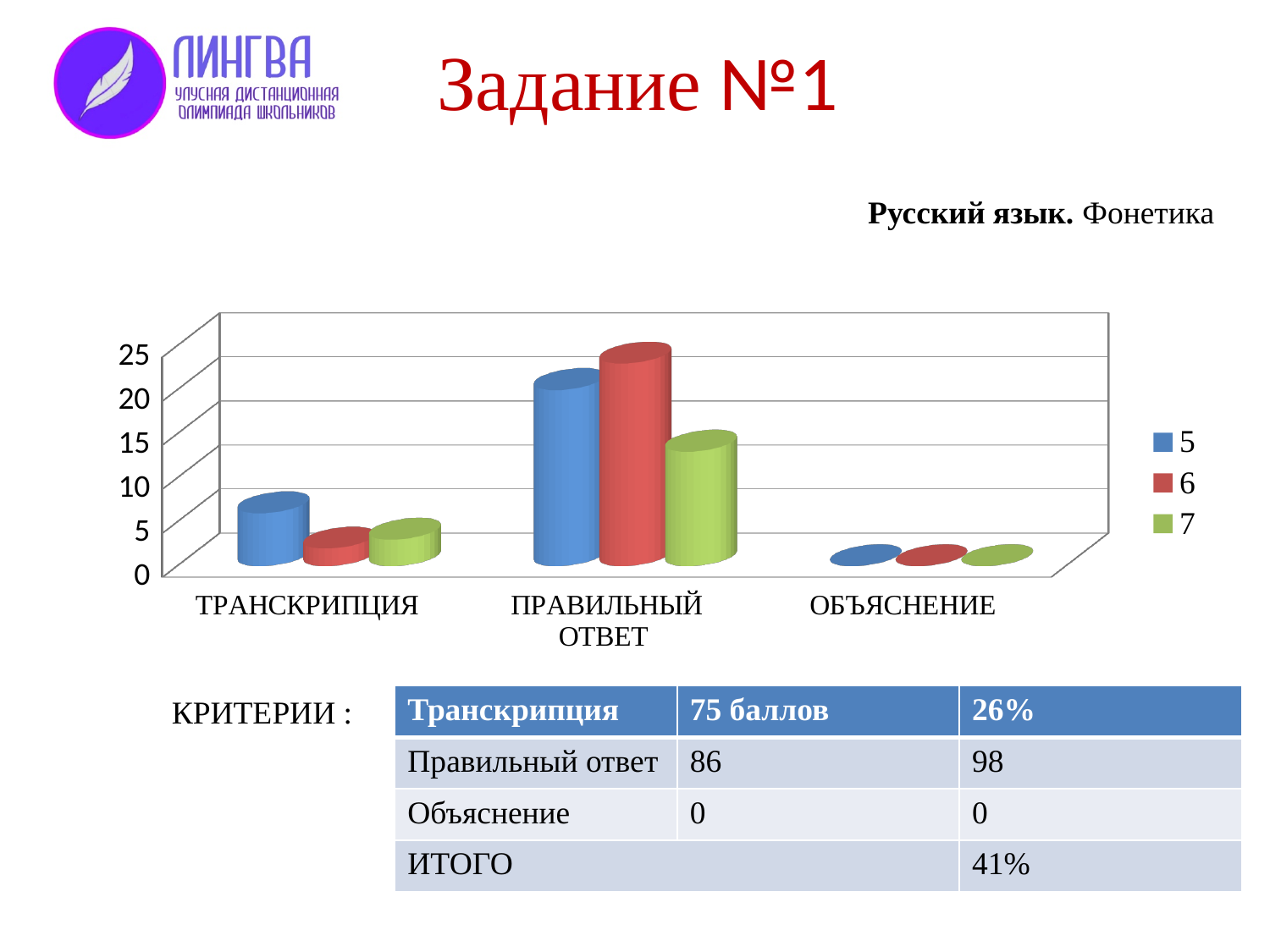
For ПРАВИЛЬНЫЙ ОТВЕТ, is the value for series 6 greater or less than 20? greater What kind of chart is shown on the slide? bar chart For ПРАВИЛЬНЫЙ ОТВЕТ, is the value for series 7 greater or less than 10? greater Which series has the tallest bar for ТРАНСКРИПЦИЯ? 5 Which category has the highest values in the chart? ПРАВИЛЬНЫЙ ОТВЕТ Which category has the lowest values in the chart? ОБЪЯСНЕНИЕ How many series does the chart legend list? 3 For ТРАНСКРИПЦИЯ, is the value for series 5 greater or less than 10? less What are the series names listed in the chart legend? 5, 6, 7 For ПРАВИЛЬНЫЙ ОТВЕТ, which is larger: the value for series 5 or series 7? series 5 Which series has the tallest bar for ПРАВИЛЬНЫЙ ОТВЕТ? 6 How many categories are shown on the x axis of the chart? 3